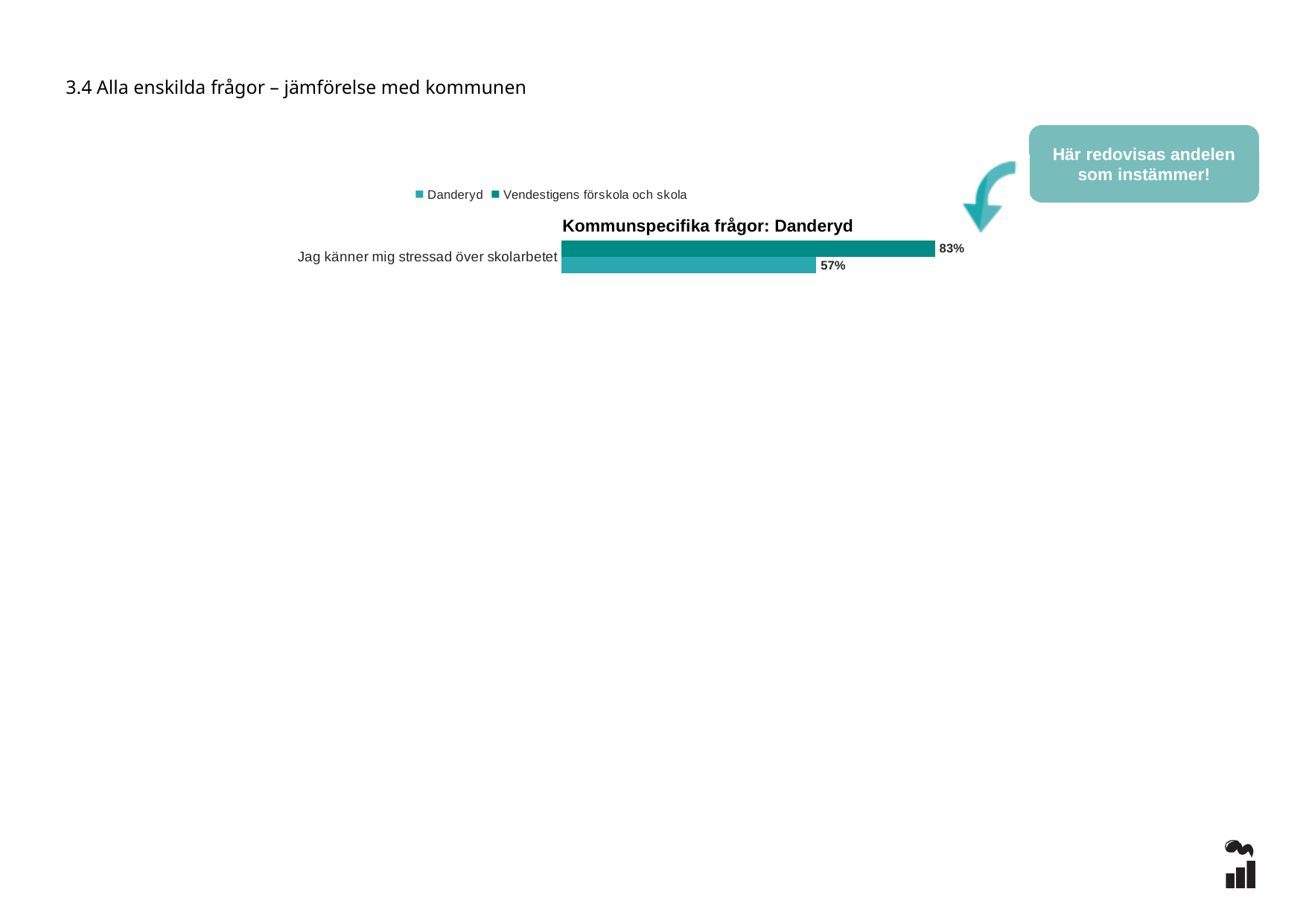
Is the value for Danderyd larger or smaller than the value for Vendestigens förskola och skola? smaller What are the two series listed in the legend? Danderyd and Vendestigens förskola och skola Which series has the lower value for "Jag känner mig stressad över skolarbetet"? Danderyd How many categories are plotted on the chart? 1 What is the title of the chart? Kommunspecifika frågor: Danderyd What is the value for Danderyd for "Jag känner mig stressad över skolarbetet"? 57% Which series has the higher value for "Jag känner mig stressad över skolarbetet"? Vendestigens förskola och skola What is the value for Vendestigens förskola och skola for "Jag känner mig stressad över skolarbetet"? 83% What is the difference between the Vendestigens förskola och skola value and the Danderyd value? 26% What kind of chart is shown? bar chart How many series does the legend list? 2